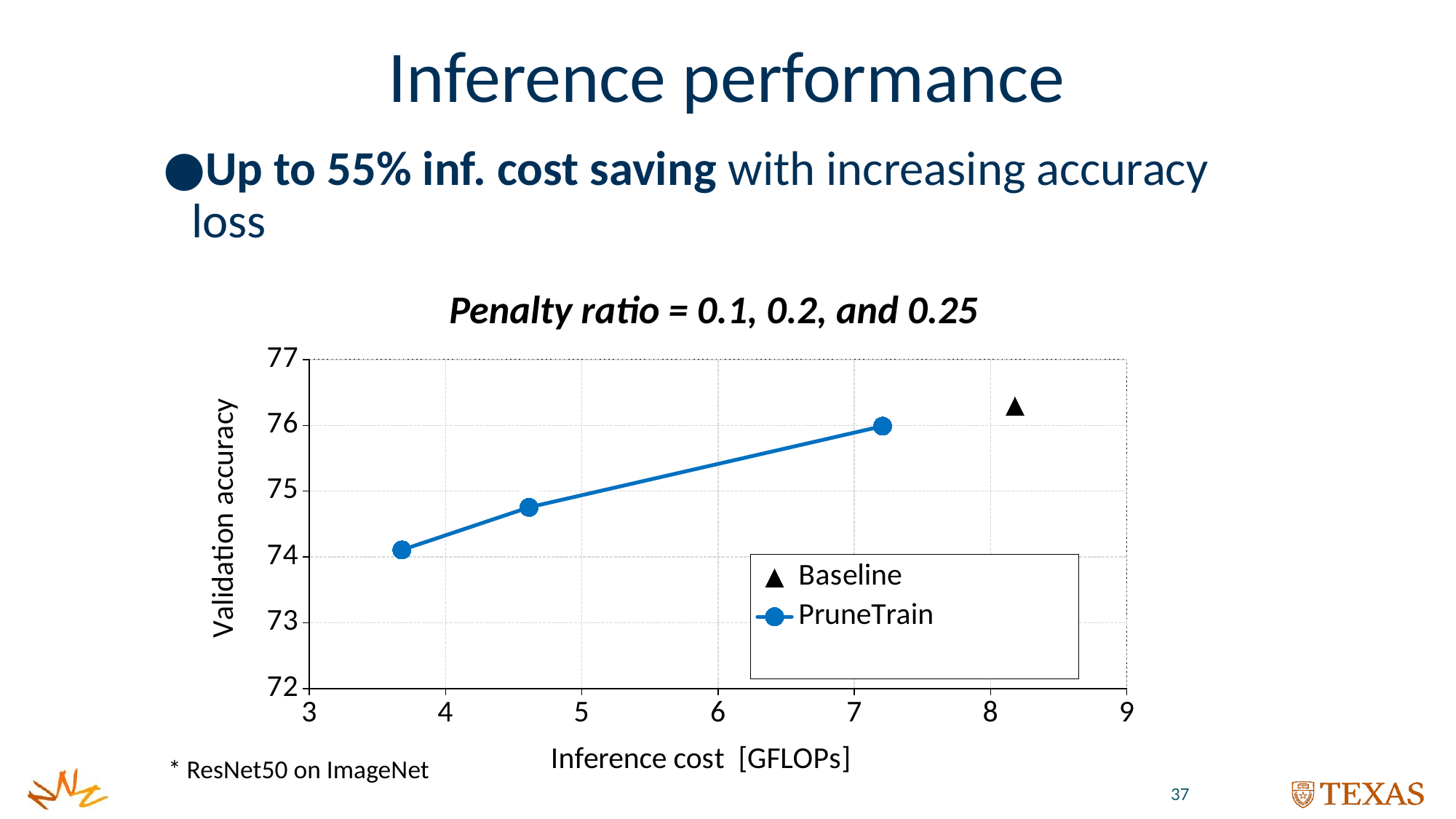
Is the inference cost of the leftmost PruneTrain point greater or less than 4 GFLOPs? less Is the validation accuracy of the leftmost PruneTrain point greater or less than 75? less How many series does the chart legend list? 2 Does the validation accuracy of the PruneTrain series rise or fall as inference cost increases along the x axis? rises Is the inference cost of the Baseline point greater or less than 8 GFLOPs? greater Which series has the higher inference cost, Baseline or PruneTrain? Baseline How many PruneTrain data points are plotted on the chart? 3 What is the label of the chart's x axis? Inference cost [GFLOPs] How many Baseline data points are plotted on the chart? 1 What is the title of the chart? Penalty ratio = 0.1, 0.2, and 0.25 What kind of chart is shown on the slide? line chart